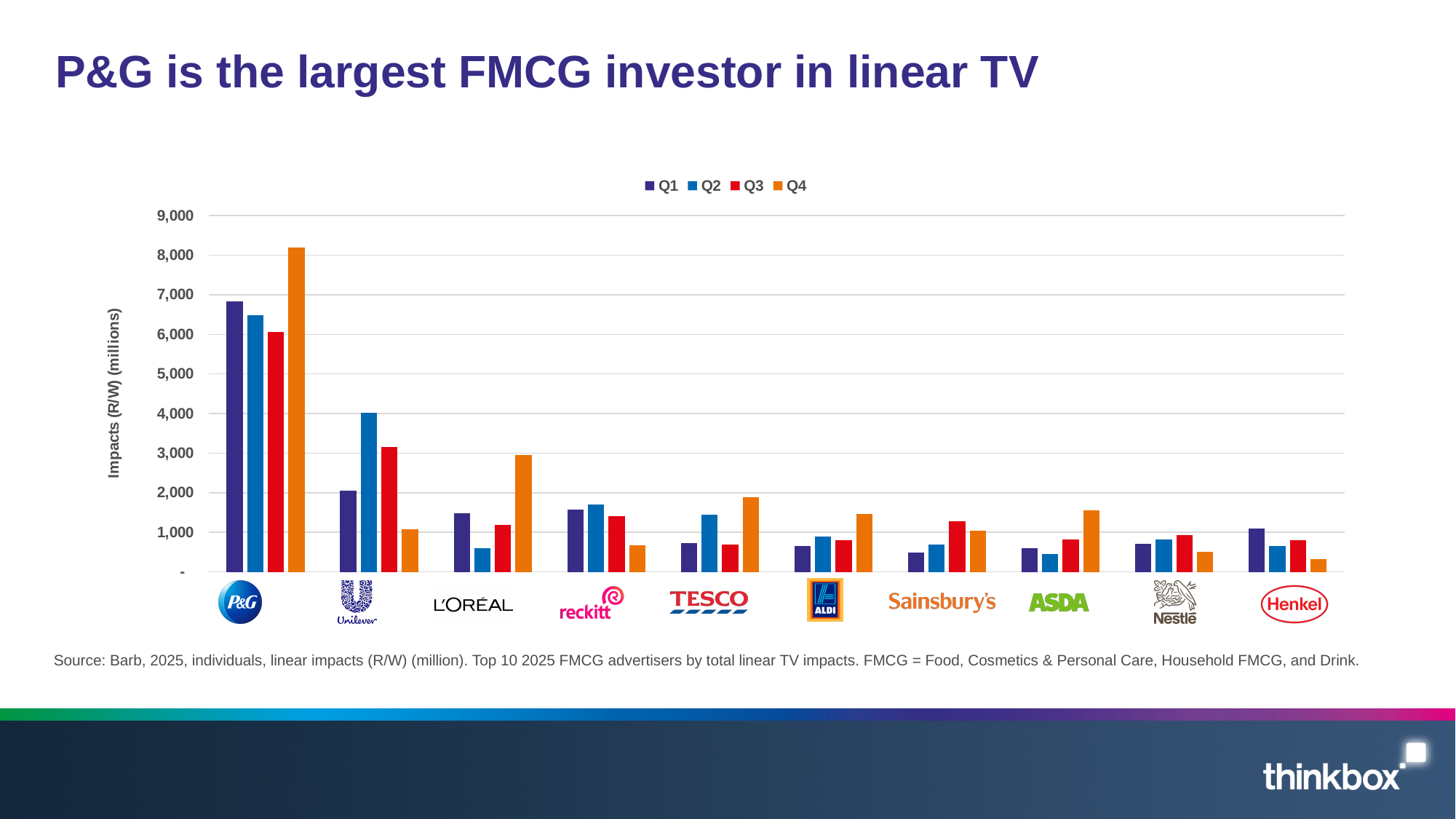
How many series does the legend list? 4 Which advertiser has the highest Q4 bar? P&G Is the Q4 value for Henkel greater or less than 1,000? less What kind of chart is shown on the slide? bar chart For Henkel, which quarter has the lowest value? Q4 Which is larger for P&G, the Q1 value or the Q3 value? Q1 What is the label of the y axis? Impacts (R/W) (millions) Is the Q2 value for Unilever greater or less than 3,000? greater For Unilever, which quarter has the highest value? Q2 For P&G, which quarter has the highest value? Q4 How many advertisers are shown on the x axis? 10 Is the Q4 value for P&G greater or less than 8,000? greater